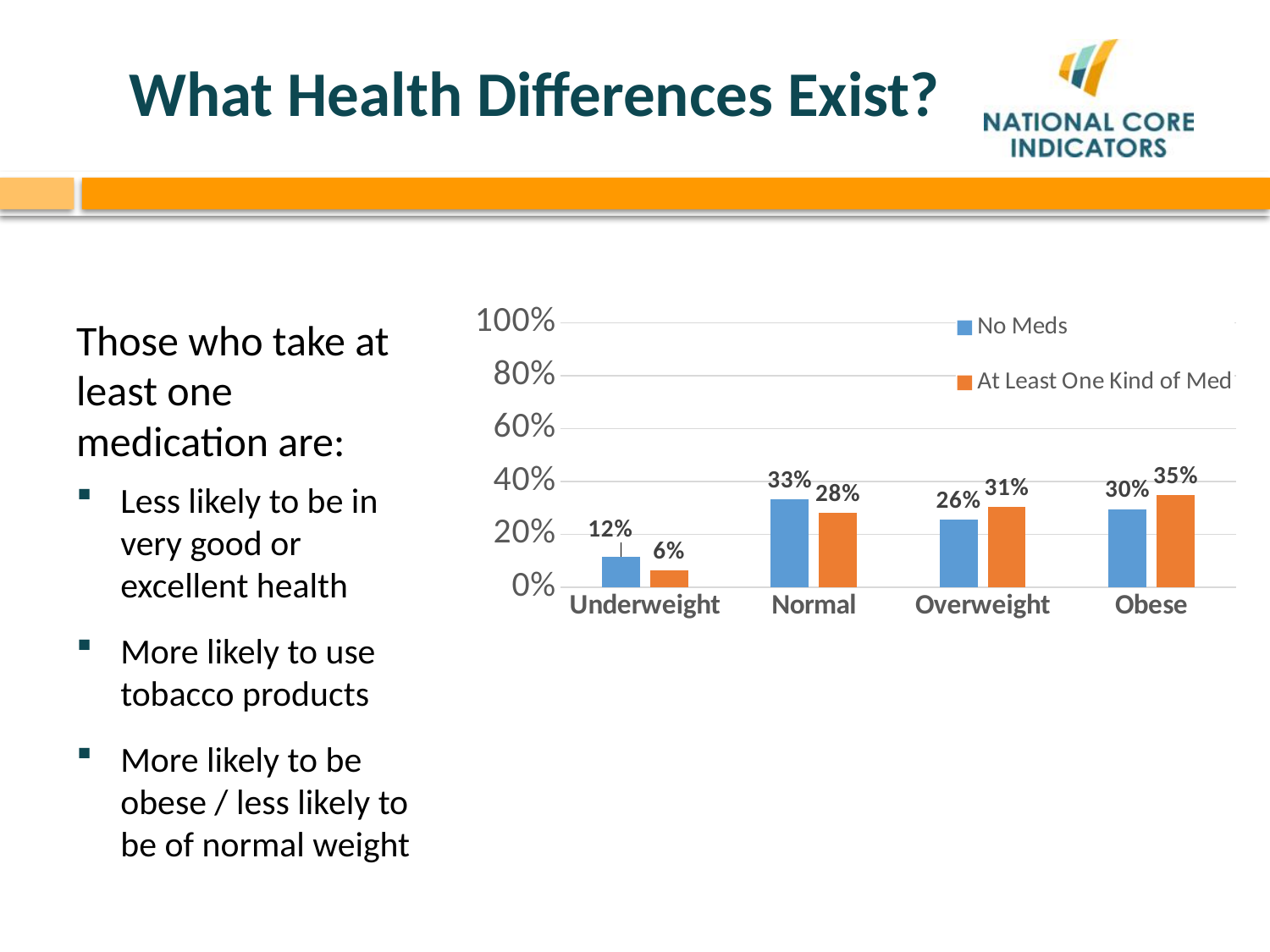
In the Normal category, which series has the larger value, No Meds or At Least One Kind of Med? No Meds What is the value for At Least One Kind of Med in the Obese category? 35% What is the value for At Least One Kind of Med in the Normal category? 28% What is the difference between the No Meds and At Least One Kind of Med values in the Overweight category? 5% How many categories are shown on the x axis? 4 What is the value for No Meds in the Underweight category? 12% What kind of chart is shown on the slide? bar chart What colour are the bars for the At Least One Kind of Med series? orange Is the value for At Least One Kind of Med in the Underweight category greater or less than 20%? less Which category has the lowest value for the No Meds series? Underweight Which category has the highest value for the At Least One Kind of Med series? Obese How many series does the legend list? 2